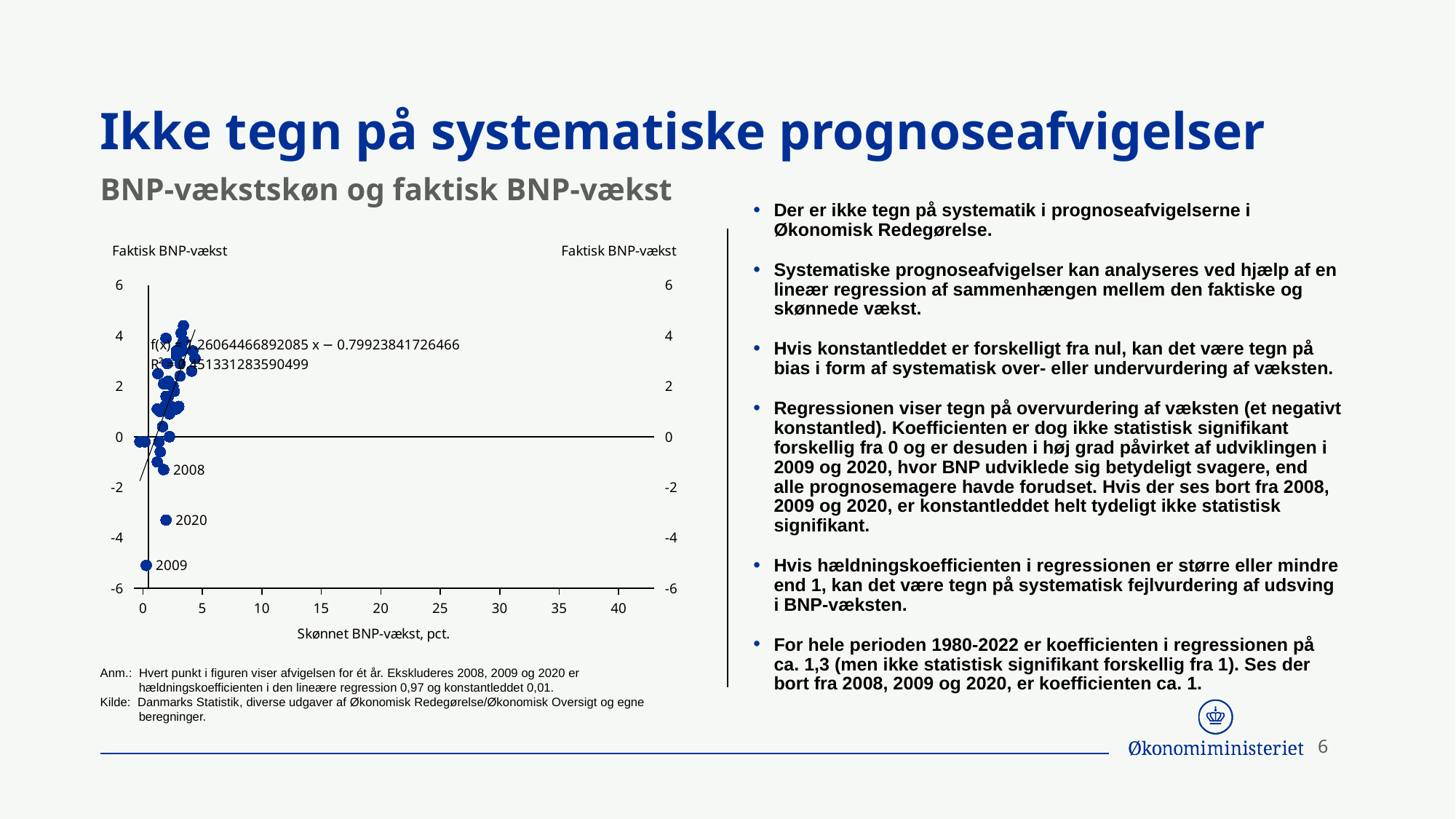
Among the labelled points 2008, 2009 and 2020, which has the lowest actual GDP growth (Faktisk BNP-vækst)? 2009 Among the labelled points 2008, 2009 and 2020, which has the highest actual GDP growth (Faktisk BNP-vækst)? 2008 Is the actual GDP growth value for the point labelled 2008 greater or less than 0? less What is the title of the chart? BNP-vækstskøn og faktisk BNP-vækst Which labelled point has the higher actual GDP growth, 2008 or 2020? 2008 What kind of chart is shown on the slide? scatter chart Is the actual GDP growth value for the point labelled 2020 greater or less than -4? greater What is the label of the x axis of the chart? Skønnet BNP-vækst, pct. Is the actual GDP growth value for the point labelled 2020 greater or less than -2? less Which labelled point has the lower actual GDP growth, 2020 or 2009? 2009